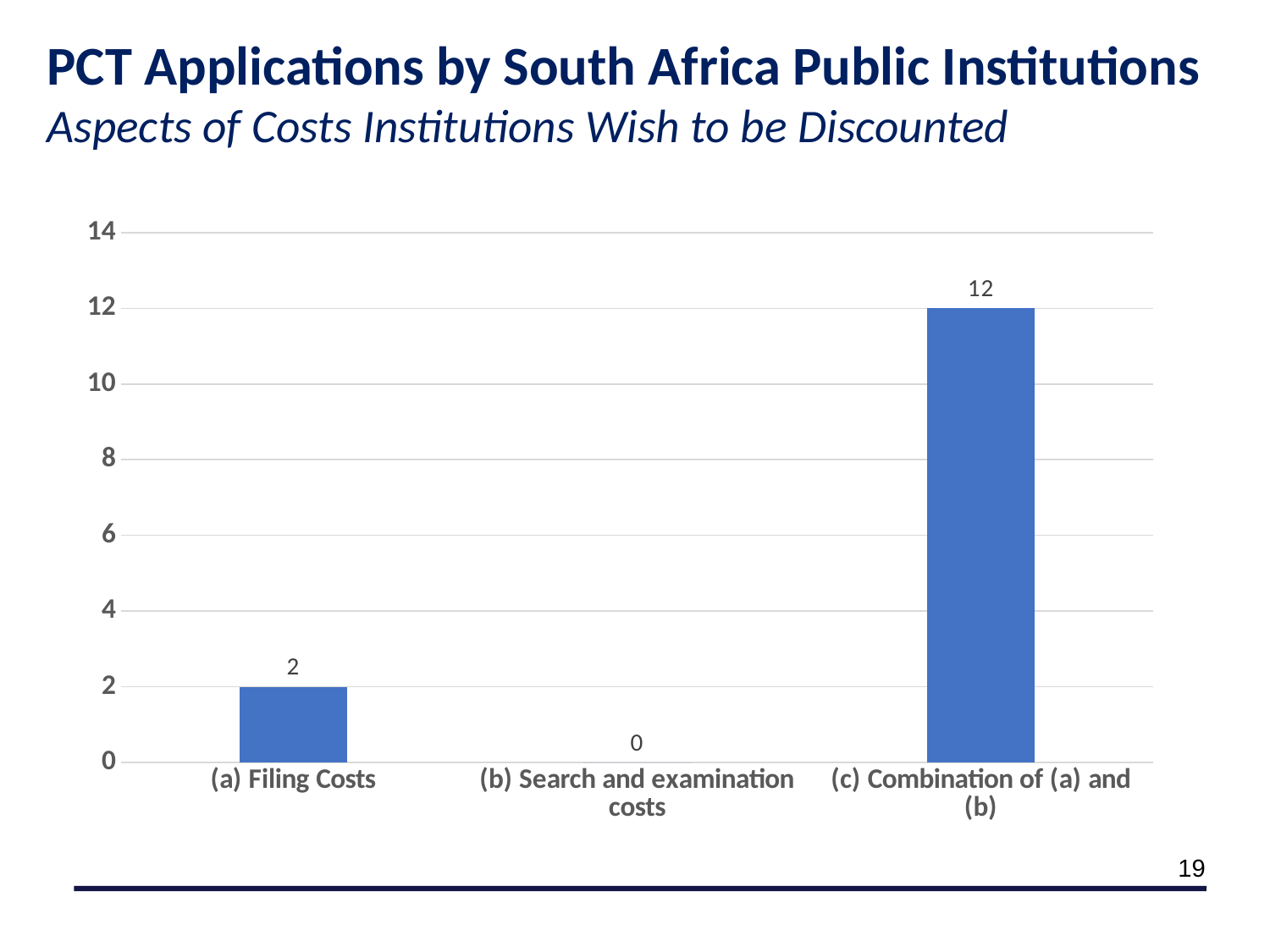
Is the value for (c) Combination of (a) and (b) greater or less than 10? greater What is the difference between the values for (c) Combination of (a) and (b) and (a) Filing Costs? 10 Which is larger, the value for (a) Filing Costs or the value for (c) Combination of (a) and (b)? (c) Combination of (a) and (b) What is the value for (c) Combination of (a) and (b)? 12 What is the value for (a) Filing Costs? 2 What is the subtitle of the slide, shown in italics below the main title? Aspects of Costs Institutions Wish to be Discounted Which category has the highest value? (c) Combination of (a) and (b) What is the total of the three values shown in the chart? 14 What kind of chart is shown on the slide? bar chart How many categories are shown on the x axis? 3 What is the value for (b) Search and examination costs? 0 Which category has the lowest value? (b) Search and examination costs